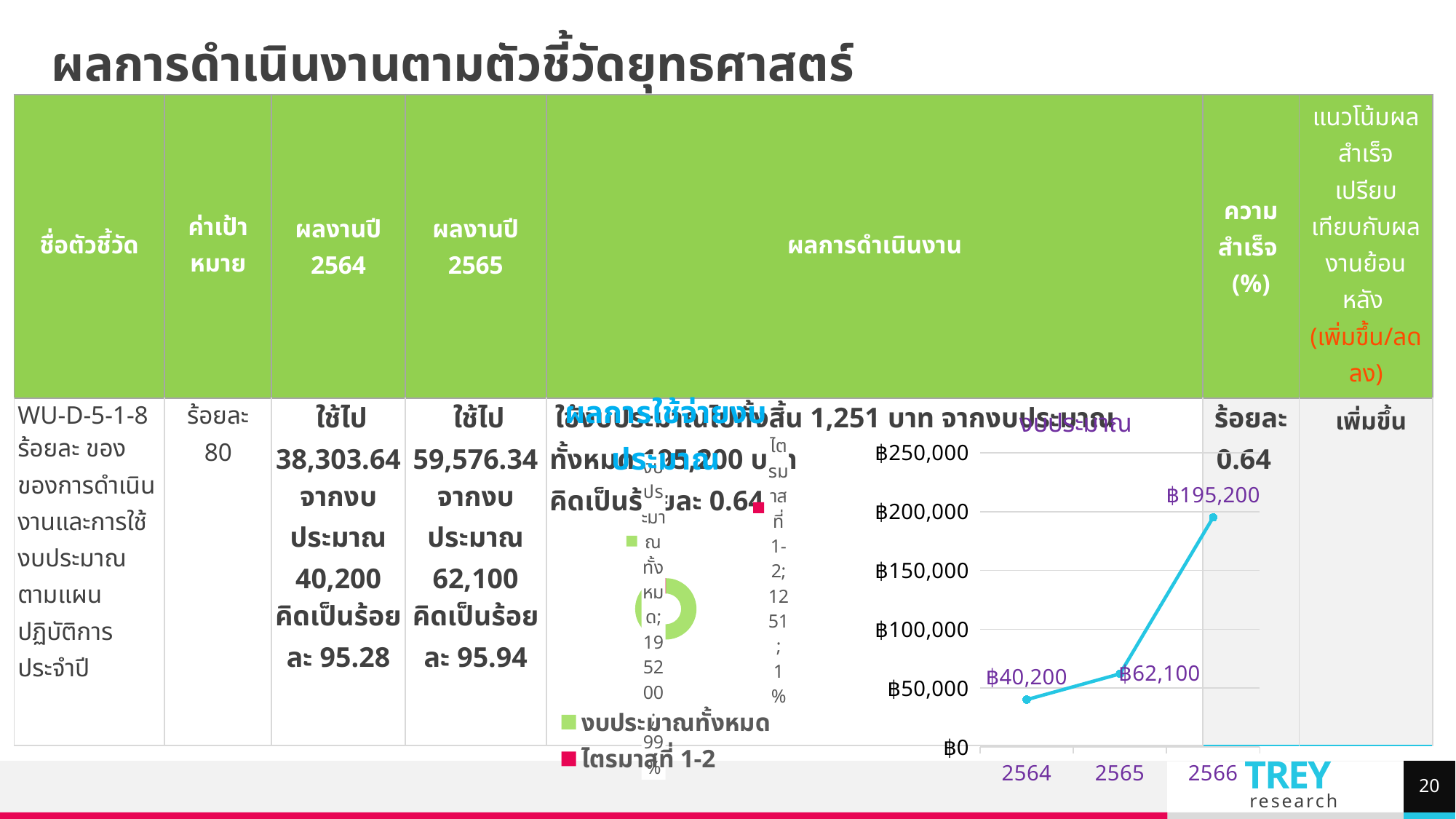
In the line chart on the right, which is larger, the value for 2565 or the value for 2564? 2565 In the line chart on the right, which year has the highest value? 2566 How many data points are plotted in the line chart on the right? 3 In the line chart on the right, what is the difference between the values for 2565 and 2564? ฿21,900 In the line chart on the right, what is the value for 2565? ฿62,100 In the line chart on the right, what is the value for 2566? ฿195,200 In the line chart on the right, do the values rise or fall from 2564 to 2566? rise What kind of chart is the chart on the right of the slide? line chart How many entries does the legend of the doughnut chart on the left list? 2 In the line chart on the right, which year has the lowest value? 2564 In the line chart on the right, what is the difference between the values for 2566 and 2565? ฿133,100 In the line chart on the right, what is the value for 2564? ฿40,200